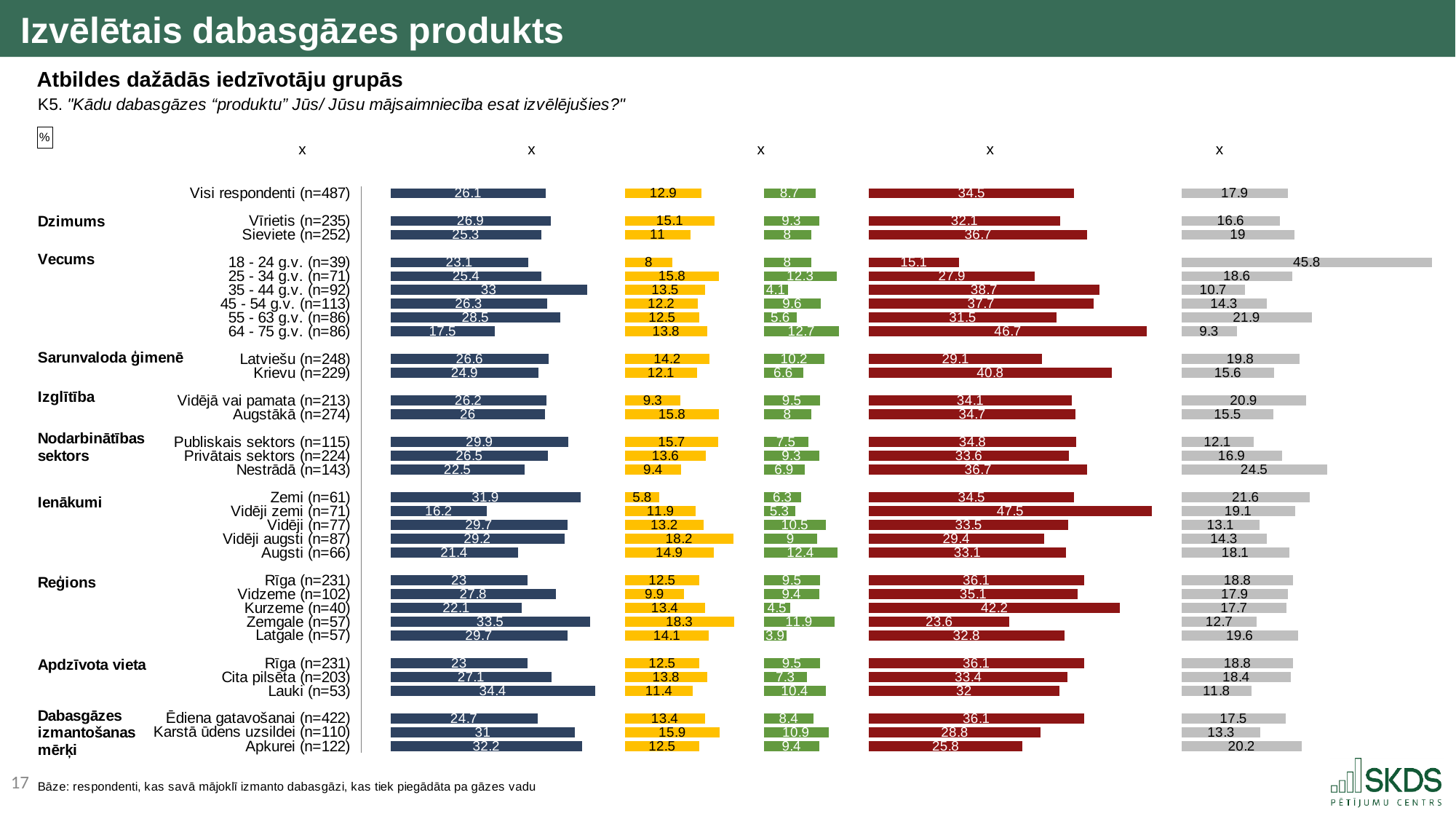
In the fourth (dark red) chart, what is the value for 64 - 75 g.v. (n=86)? 46.7 How many age groups (Vecums) are shown on the slide? 6 In the third (green) chart, what is the value for Latgale (n=57)? 3.9 In the fourth (dark red) chart, what is the difference between the values for Krievu (n=229) and Latviešu (n=248)? 11.7 What kind of chart is used on the slide? Bar chart In the fifth (grey) chart, which age group (Vecums) has the highest value? 18 - 24 g.v. (n=39) In the fifth (grey) chart, what is the value for Nestrādā (n=143)? 24.5 In the first (dark blue) chart, which income group (Ienākumi) has the lowest value? Vidēji zemi (n=71) In the fourth (dark red) chart, which region (Reģions) has the highest value? Kurzeme (n=40) In the first (dark blue) chart, what is the difference between the values for Lauki (n=53) and Rīga (n=231)? 11.4 In the second (yellow) chart, which is larger: the value for Vidēji augsti (n=87) or for Zemi (n=61)? Vidēji augsti (n=87) In the first (dark blue) chart, what is the value for Visi respondenti (n=487)? 26.1